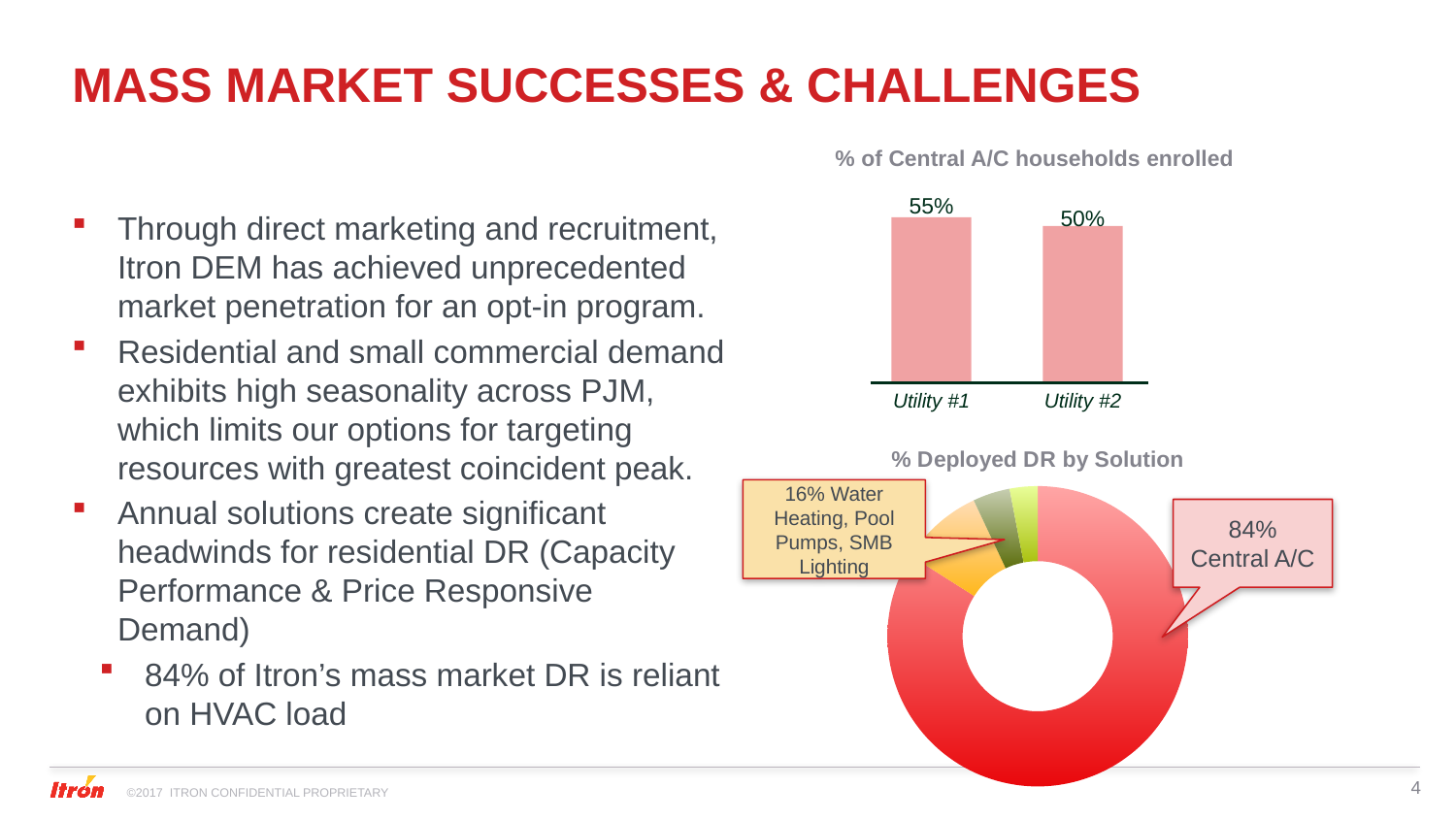
In the '% of Central A/C households enrolled' chart, which utility has the higher enrollment? Utility #1 What is the title of the chart at the top right of the slide? % of Central A/C households enrolled In the '% of Central A/C households enrolled' chart, do the values rise or fall from Utility #1 to Utility #2? Fall In the '% of Central A/C households enrolled' chart, what is the difference between Utility #1 and Utility #2? 5% What type of chart is the '% of Central A/C households enrolled' chart? Bar chart In the '% Deployed DR by Solution' chart, what share is Central A/C? 84% In the '% of Central A/C households enrolled' chart, what is the value for Utility #2? 50% What type of chart is the '% Deployed DR by Solution' chart? Doughnut chart In the '% Deployed DR by Solution' chart, what share is Water Heating, Pool Pumps, SMB Lighting? 16% In the '% of Central A/C households enrolled' chart, which utility has the lower enrollment? Utility #2 In the '% of Central A/C households enrolled' chart, how many utilities are shown? 2 In the '% of Central A/C households enrolled' chart, what is the value for Utility #1? 55%